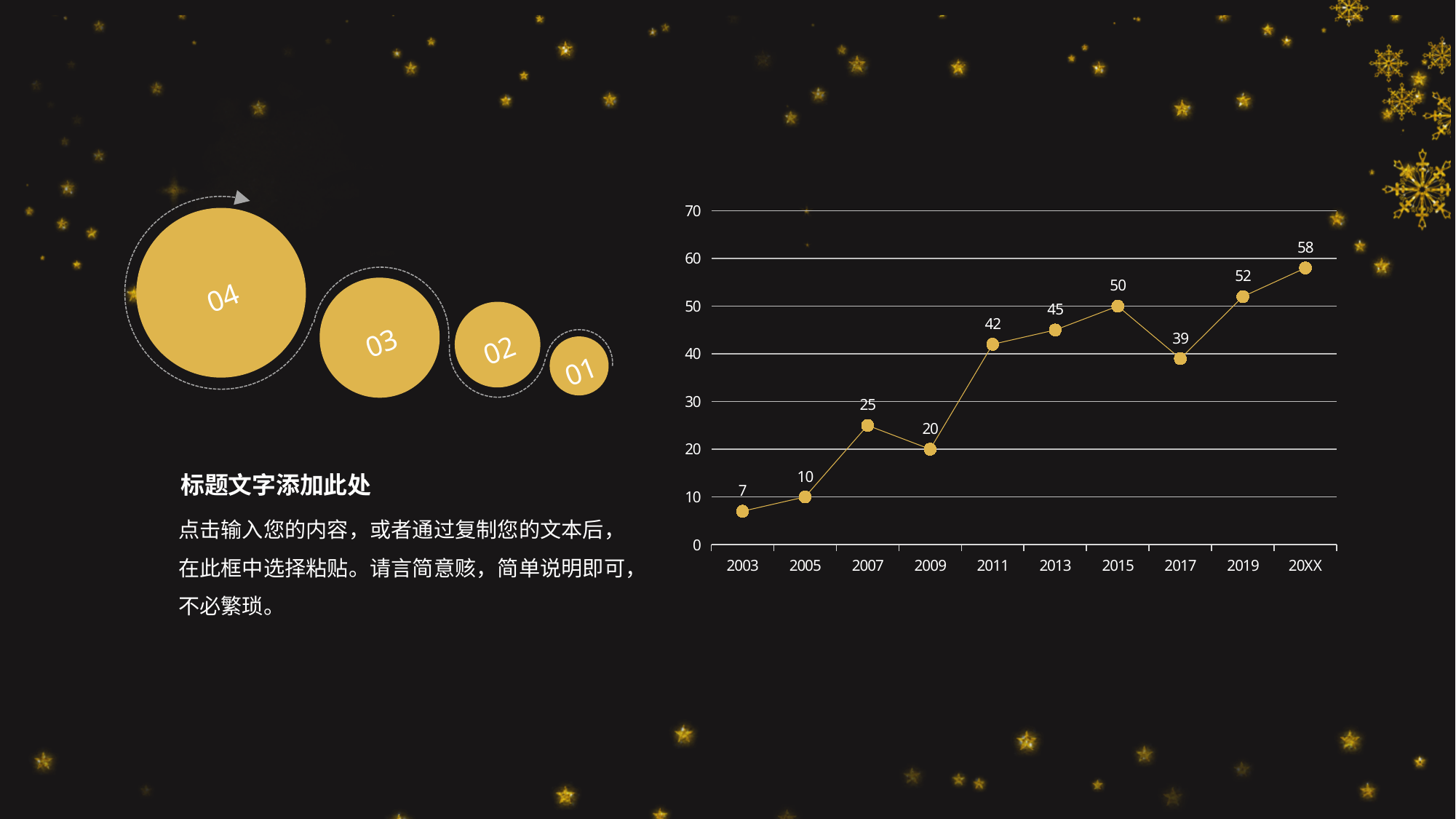
What is the value for 2017? 39 What is the value for 2011? 42 What is the difference between the values for 20XX and 2003? 51 How many data points are plotted on the chart? 10 What kind of chart is shown on the slide? line chart What is the difference between the values for 2015 and 2017? 11 What is the value for 2003? 7 Is the value for 2013 greater or less than 40? greater Do the values generally rise or fall from 2003 to 20XX? rise Which is larger, the value for 2007 or the value for 2009? 2007 Which year has the highest value? 20XX Which year has the lowest value? 2003